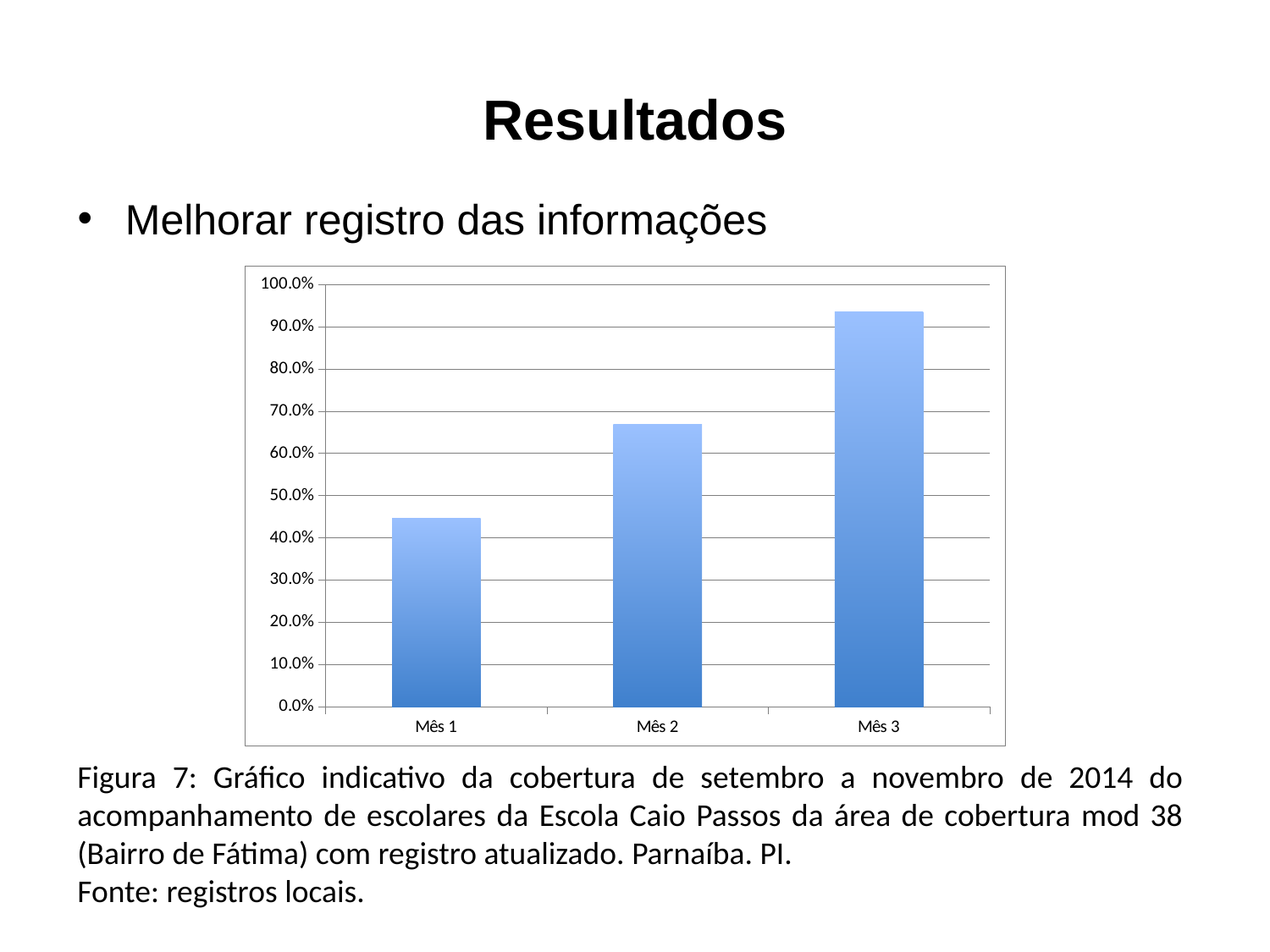
Is the value for Mês 1 greater or less than 40.0%? greater What is the highest value shown on the y axis of the chart? 100.0% How many categories are shown on the x axis of the chart? 3 Is the value for Mês 3 greater or less than 90.0%? greater Is the value for Mês 2 greater or less than 60.0%? greater Do the values rise or fall from Mês 1 to Mês 3? rise Which category has the highest value in the chart? Mês 3 Which is larger, the value for Mês 2 or the value for Mês 3? Mês 3 Which category has the lowest value in the chart? Mês 1 What kind of chart is shown on the slide? bar chart